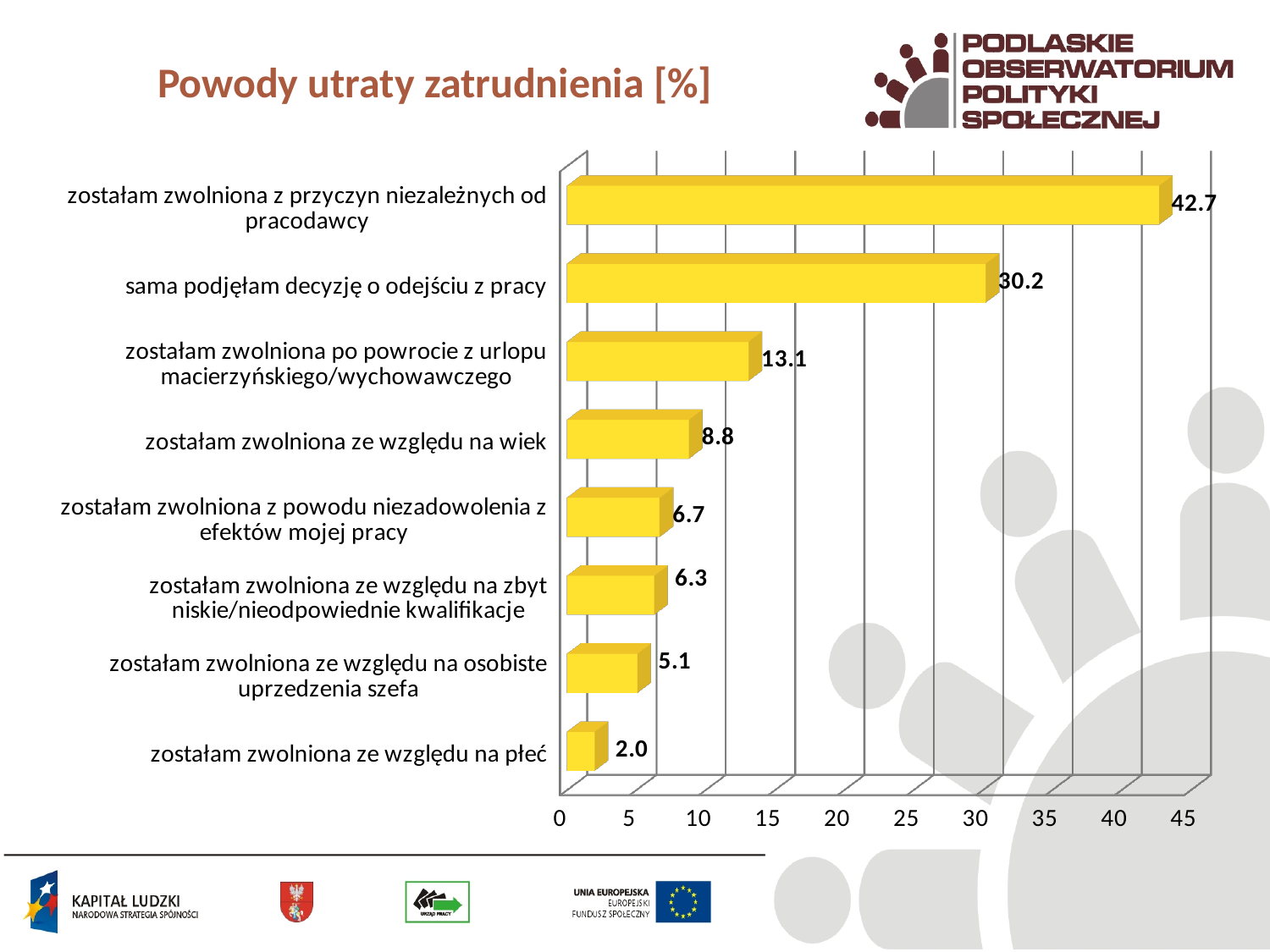
What is the value for "sama podjęłam decyzję o odejściu z pracy"? 30.2 What is the value for "zostałam zwolniona ze względu na wiek"? 8.8 What is the value for "zostałam zwolniona z przyczyn niezależnych od pracodawcy"? 42.7 How many categories are shown in the chart? 8 Which category has the lowest value? zostałam zwolniona ze względu na płeć Which is larger: the value for "zostałam zwolniona po powrocie z urlopu macierzyńskiego/wychowawczego" or for "zostałam zwolniona ze względu na wiek"? zostałam zwolniona po powrocie z urlopu macierzyńskiego/wychowawczego What is the difference between the values for "zostałam zwolniona z przyczyn niezależnych od pracodawcy" and "sama podjęłam decyzję o odejściu z pracy"? 12.5 What is the title of the chart? Powody utraty zatrudnienia [%] What is the value for "zostałam zwolniona ze względu na płeć"? 2.0 What kind of chart is shown on the slide? bar chart Which category has the highest value? zostałam zwolniona z przyczyn niezależnych od pracodawcy Is the value for "sama podjęłam decyzję o odejściu z pracy" greater or less than 25? greater